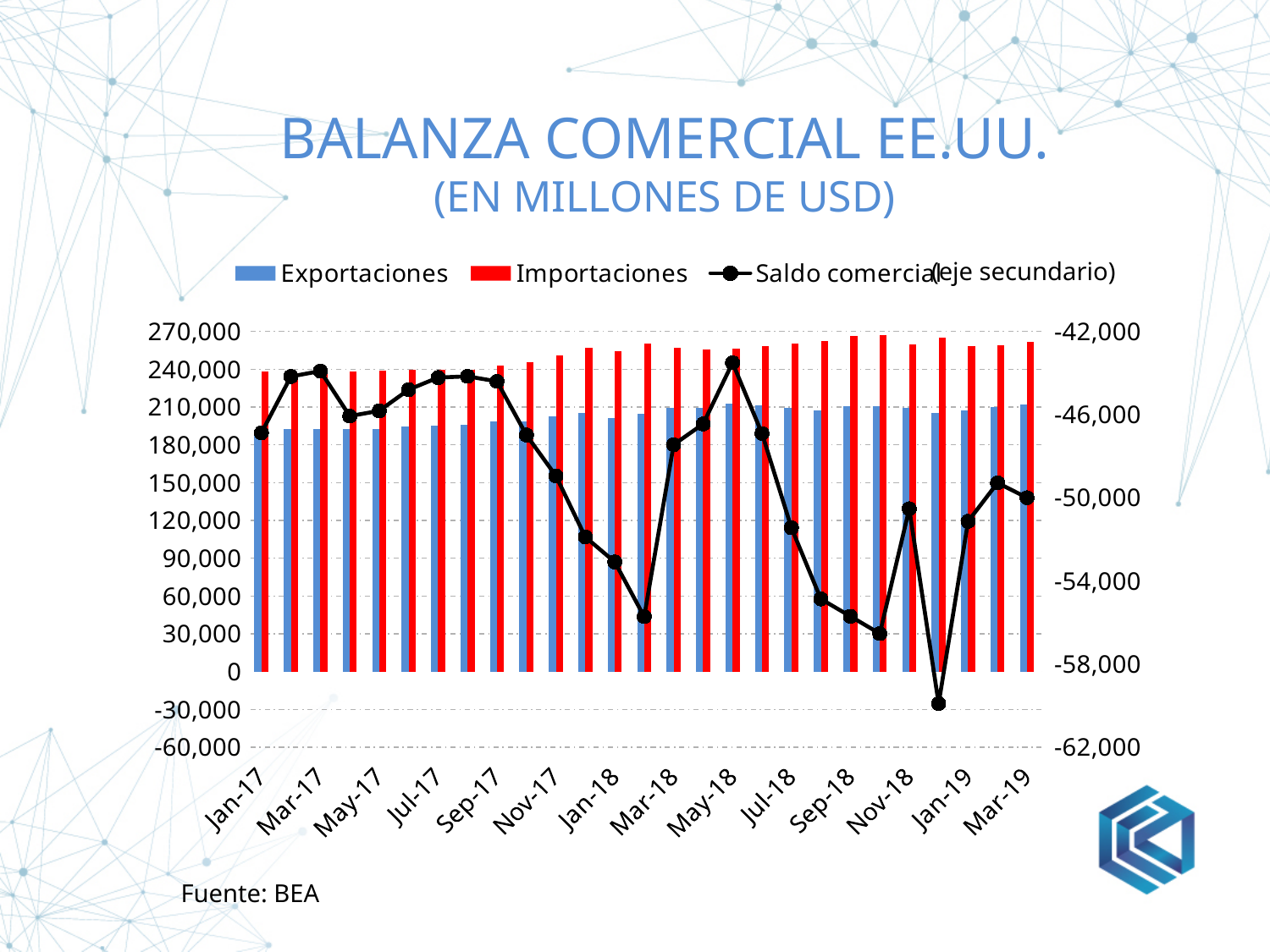
What kind of chart is shown on the slide? A combination bar and line chart Which series is plotted on the secondary axis? Saldo comercial Is the value of Exportaciones for Jan-17 greater or less than 210,000? less Is the value of Importaciones for Jan-17 greater or less than 210,000? greater In Jan-18, which is larger, Exportaciones or Importaciones? Importaciones Is the value of Saldo comercial for Mar-17 greater or less than -46,000? greater What is the title of the chart? BALANZA COMERCIAL EE.UU. (EN MILLONES DE USD) Do the Exportaciones bars generally rise or fall from Jan-17 to Mar-19? rise How many series does the legend list? 3 How many category labels are shown on the x axis? 14